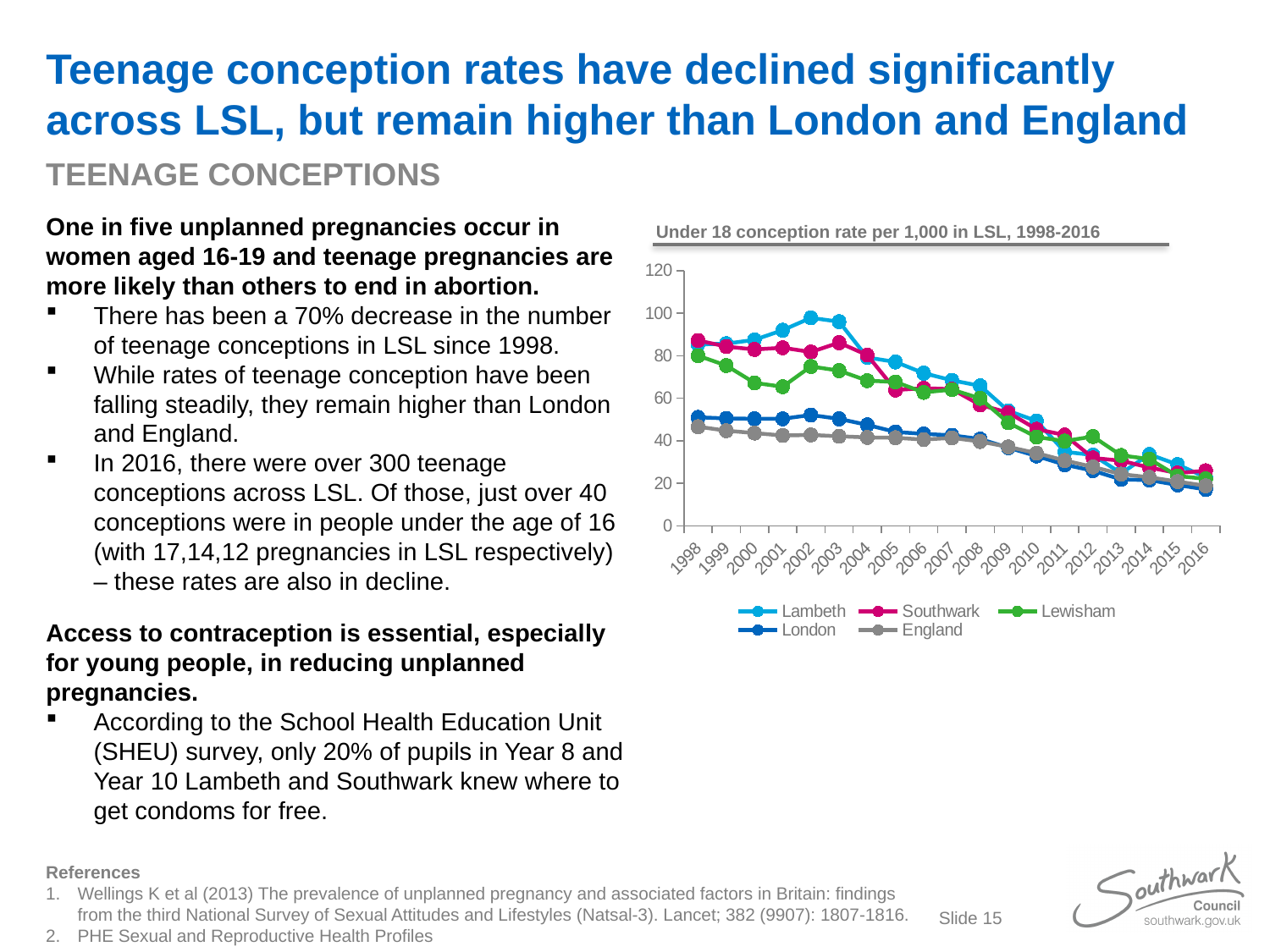
What kind of chart is shown on the slide? line chart Is the value for Lambeth in 2002 greater or less than 80? greater How many years are plotted along the x axis of the chart? 19 Do the conception rates generally rise or fall from 1998 to 2016? fall Which series is drawn in grey in the chart? England In 2001, which is larger: the value for Southwark or the value for Lewisham? Southwark Which area has the highest under 18 conception rate in 2002? Lambeth Is the value for London in 1998 greater or less than 40? greater What is the title of the chart? Under 18 conception rate per 1,000 in LSL, 1998-2016 Is the value for Lewisham in 2001 greater or less than 80? less How many series does the chart's legend list? 5 Which area has the lowest under 18 conception rate in 1998? England